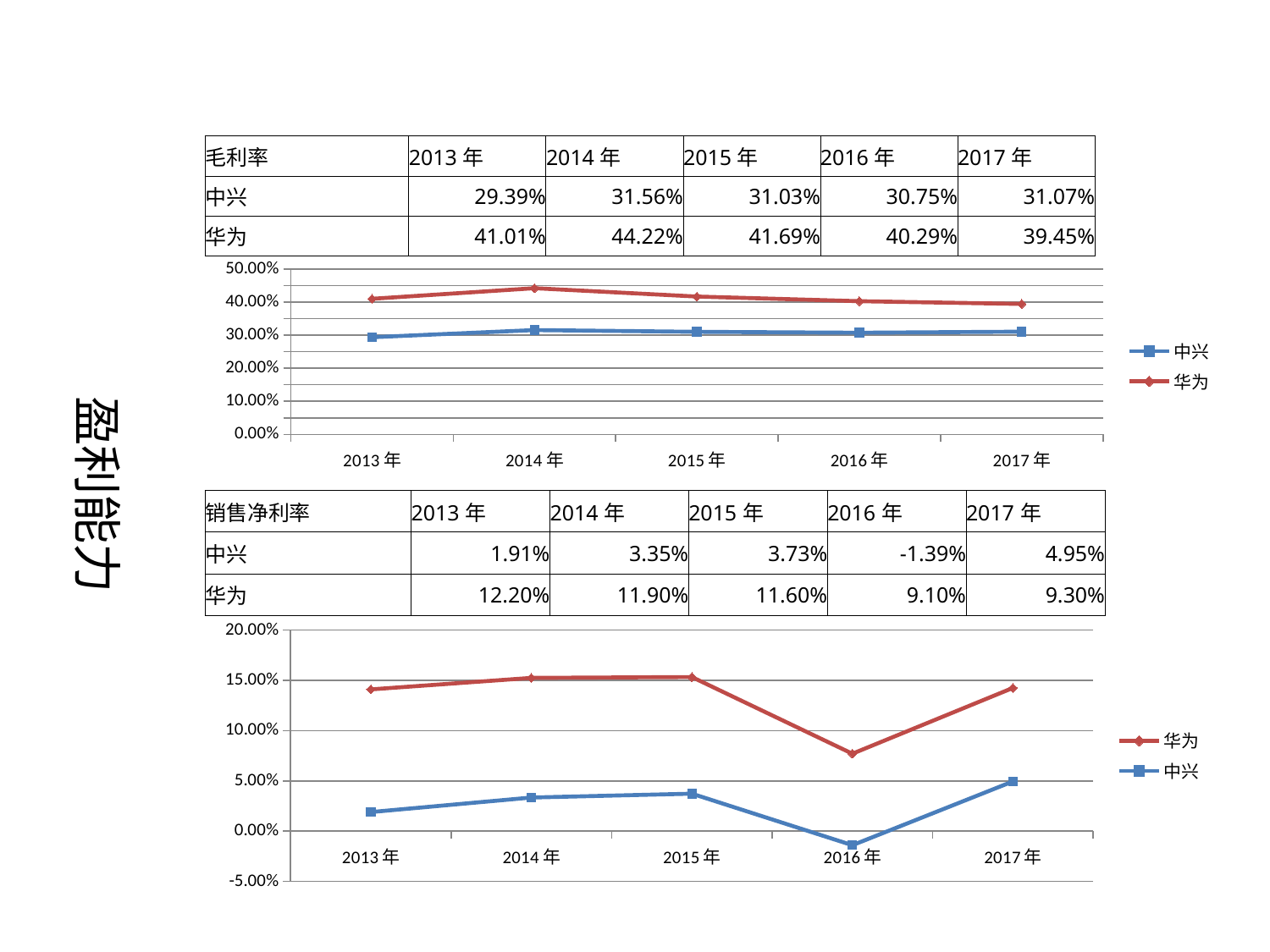
In the bottom chart, which year has the highest value for 中兴? 2017 年 What kind of chart is the top chart on the slide? line chart In the top chart, what is the value for 华为 in 2014 年? 44.22% In the bottom chart, which series is higher in 2015 年, 华为 or 中兴? 华为 In the top chart, what is the value for 中兴 in 2013 年? 29.39% In the top chart, what is the difference between 华为 and 中兴 in 2017 年? 8.38% In the top chart, how many series does the legend list? 2 In the top chart, which year has the highest value for 华为? 2014 年 How many years are plotted along the x axis of the bottom chart? 5 In the top chart, which year has the lowest value for 中兴? 2013 年 In the bottom chart, what is the value for 中兴 in 2016 年? -1.39% In the bottom chart, is the value for 华为 in 2016 年 greater or less than 10.00%? less